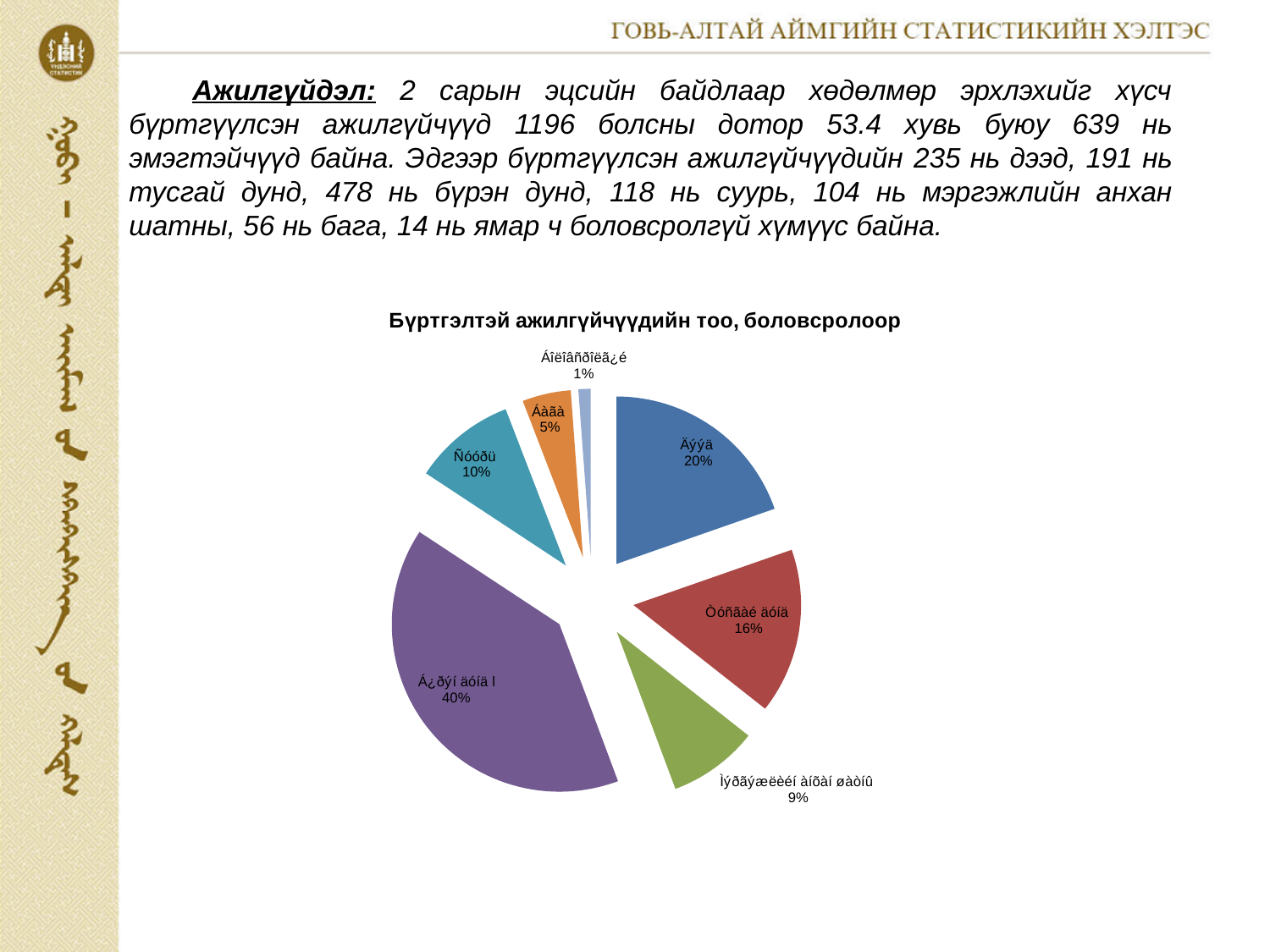
What is the title of the chart? Бүртгэлтэй ажилгүйчүүдийн тоо, боловсролоор What share is shown for the green slice of the pie chart? 9% What share is shown for the purple slice of the pie chart? 40% By how many percentage points does the purple slice exceed the dark blue slice? 20 How many slices does the pie chart have? 7 What percentage does the largest slice of the pie chart represent? 40% What share is shown for the red slice of the pie chart? 16% What share is shown for the dark blue slice of the pie chart? 20% Which slice is larger, the teal slice or the orange slice? teal slice What percentage does the smallest slice of the pie chart represent? 1% What type of chart is shown on the slide? pie chart What share is shown for the orange slice of the pie chart? 5%